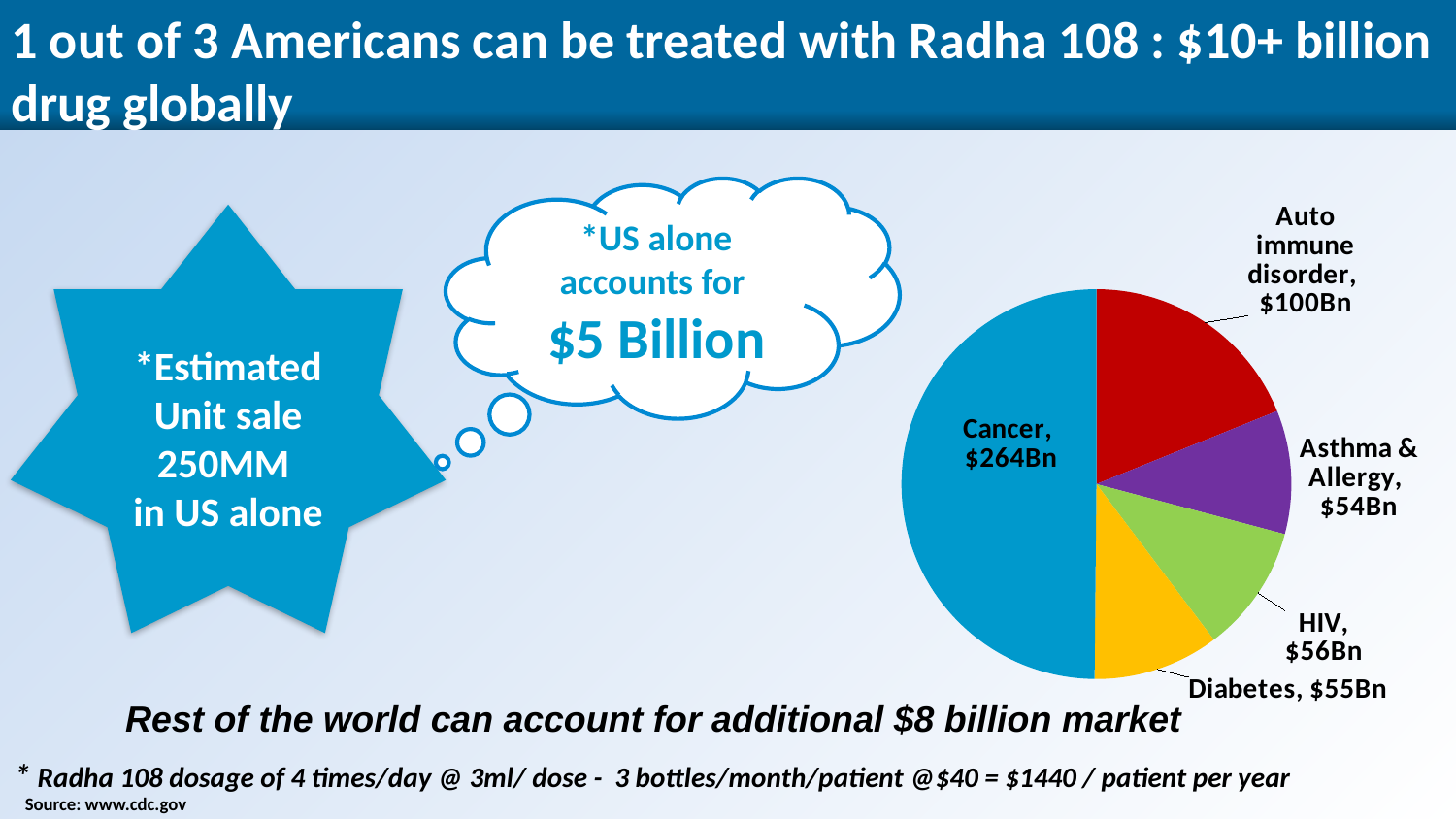
What is the value shown for Diabetes in the pie chart? $55Bn What is the value shown for Auto immune disorder in the pie chart? $100Bn Which category has the largest slice in the pie chart? Cancer What is the value shown for Asthma & Allergy in the pie chart? $54Bn What is the difference between the Auto immune disorder value and the Asthma & Allergy value in the pie chart? $46Bn What is the difference between the Cancer value and the Auto immune disorder value in the pie chart? $164Bn How many categories are shown in the pie chart? 5 What is the value shown for HIV in the pie chart? $56Bn Which is larger in the pie chart, the value for Cancer or the value for Auto immune disorder? Cancer Which category has the smallest value in the pie chart? Asthma & Allergy What type of chart is shown on the slide? Pie chart What is the value shown for Cancer in the pie chart? $264Bn